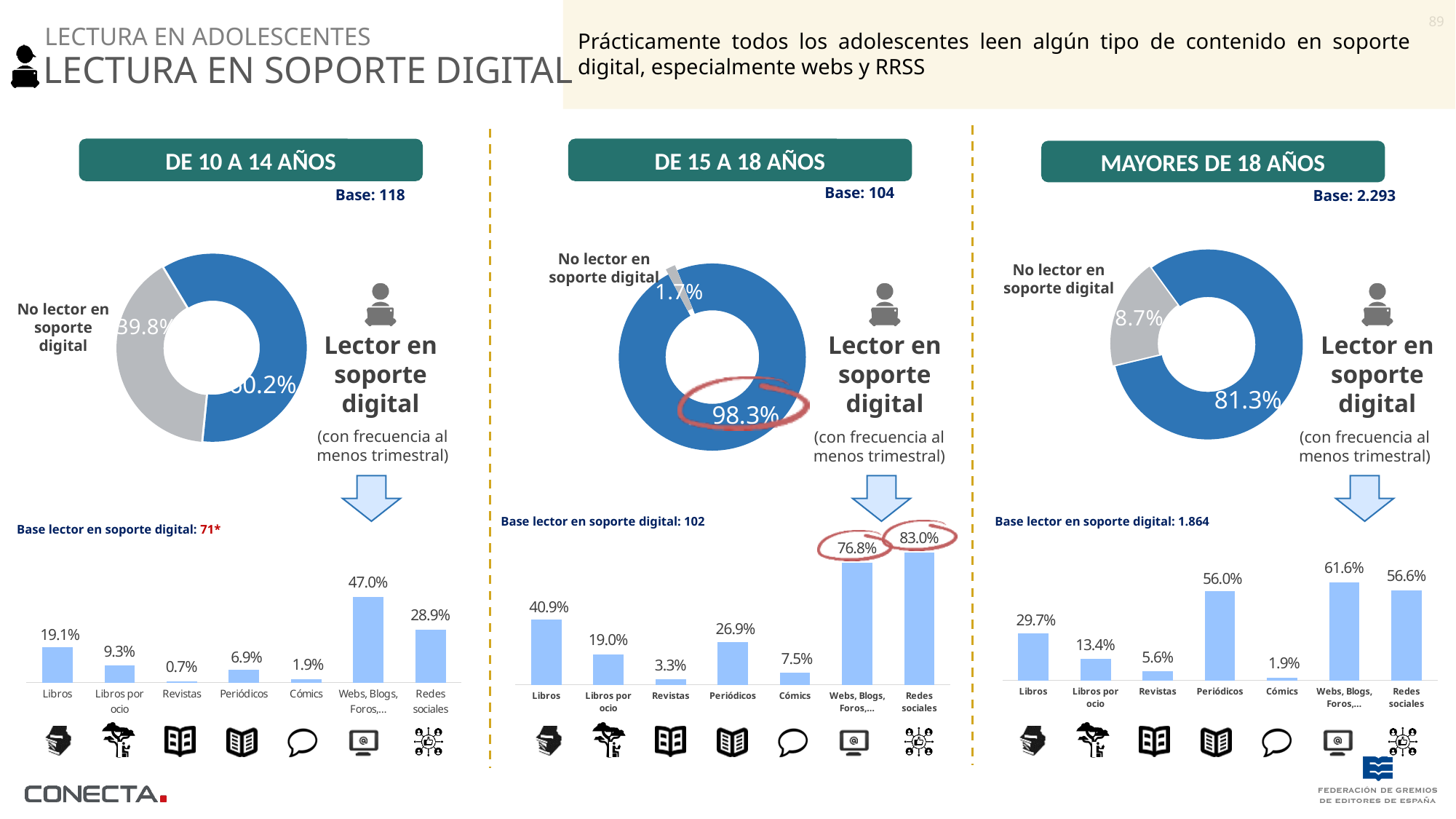
What kind of chart is used to show 'Lector en soporte digital' versus 'No lector en soporte digital' for each age group? Donut (pie) chart In the donut chart for 'MAYORES DE 18 AÑOS', what share is 'Lector en soporte digital'? 81.3% In the bar chart for 'DE 15 A 18 AÑOS', which category has the highest value? Redes sociales In the bar chart for 'DE 15 A 18 AÑOS', what is the value for Redes sociales? 83.0% In the bar chart for 'MAYORES DE 18 AÑOS', which is larger: Libros or Libros por ocio? Libros In the bar chart for 'MAYORES DE 18 AÑOS', which category has the highest value? Webs, Blogs, Foros,... How many categories does the bar chart for 'DE 10 A 14 AÑOS' show? 7 In the bar chart for 'DE 10 A 14 AÑOS', what is the value for Webs, Blogs, Foros? 47.0% In the donut chart for 'DE 15 A 18 AÑOS', what share is 'Lector en soporte digital'? 98.3% In the bar chart for 'DE 10 A 14 AÑOS', which category has the lowest value? Revistas In the bar chart for 'DE 15 A 18 AÑOS', what is the difference between Redes sociales and Webs, Blogs, Foros? 6.2% In the bar chart for 'MAYORES DE 18 AÑOS', what is the value for Periódicos? 56.0%